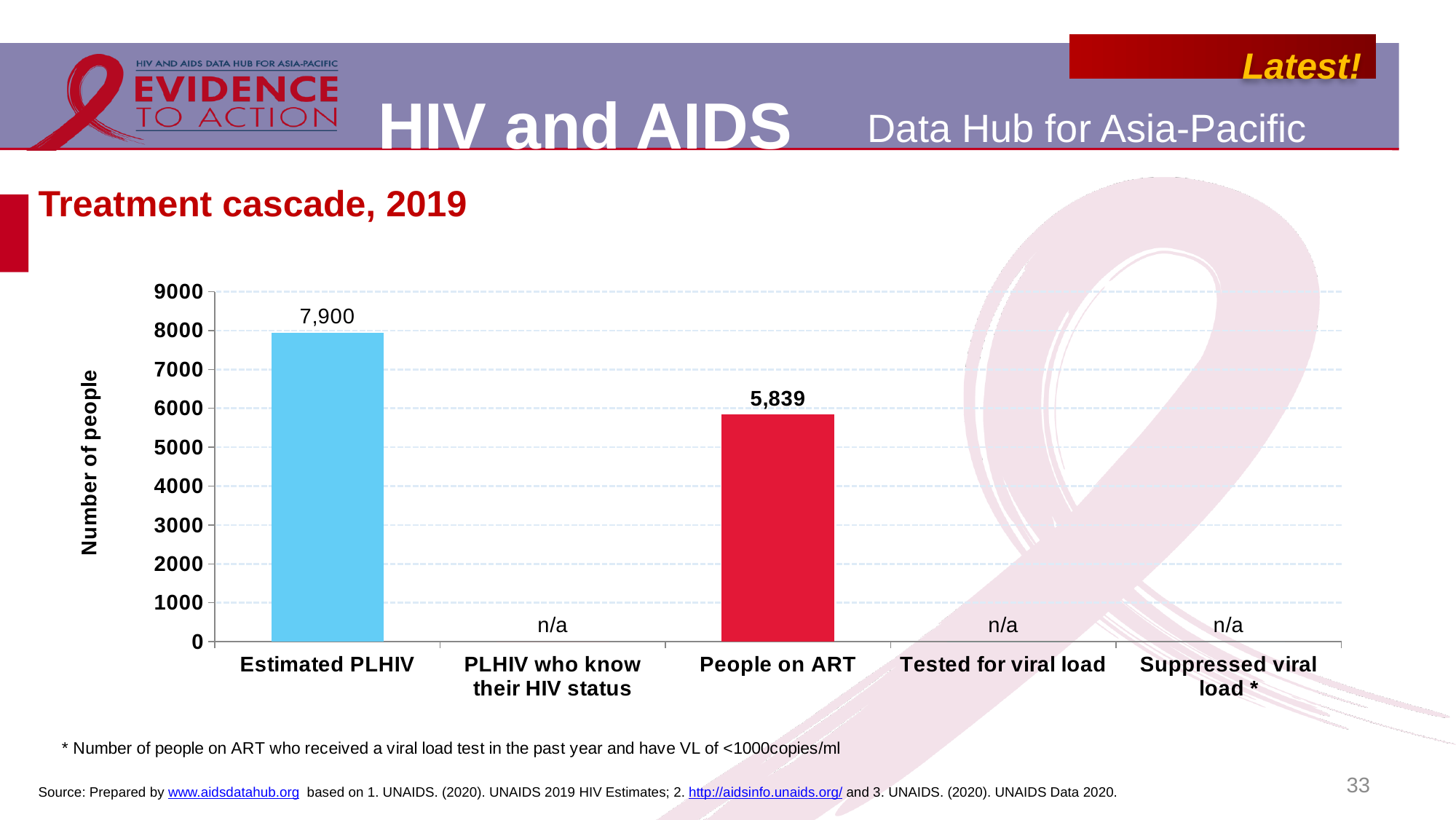
How many categories are shown on the x axis? 5 What is the difference between Estimated PLHIV and People on ART? 2,061 What is shown for PLHIV who know their HIV status? n/a What kind of chart is this? bar chart Is the value for People on ART greater or less than 6000? less What is the value for People on ART? 5,839 Which category has the highest value? Estimated PLHIV What is the title of the chart? Treatment cascade, 2019 Which is larger, Estimated PLHIV or People on ART? Estimated PLHIV What is the value for Estimated PLHIV? 7,900 What is the label of the y axis? Number of people What is shown for Tested for viral load? n/a